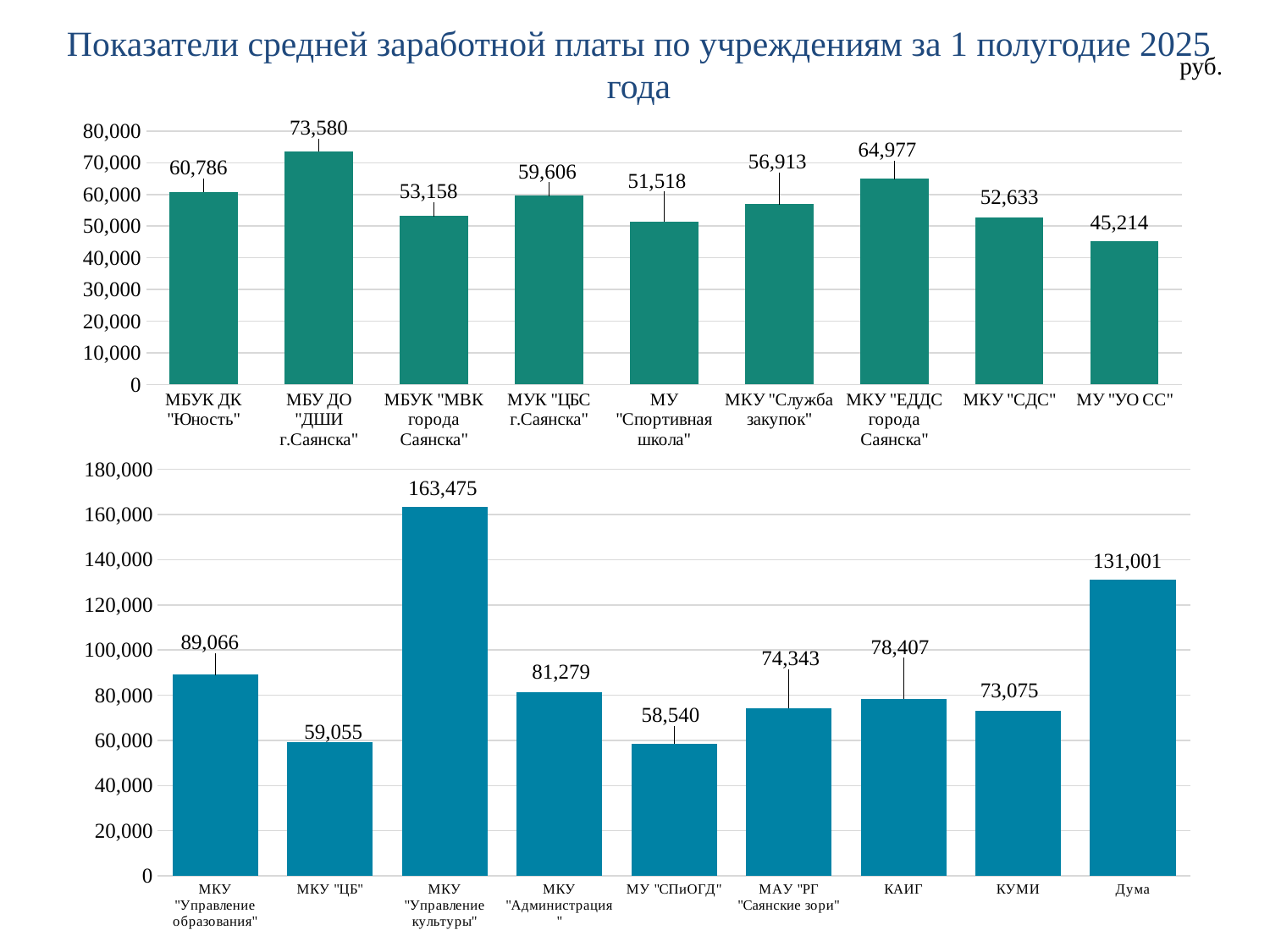
In the top chart, what is the difference between the highest and lowest values? 28,366 In the top chart, what is the value for МБУ ДО "ДШИ г.Саянска"? 73,580 In the bottom chart, what is the difference between МКУ "Управление культуры" and Дума? 32,474 In the top chart, which is larger: МКУ "Служба закупок" or МКУ "ЕДДС города Саянска"? МКУ "ЕДДС города Саянска" What is the title of the slide's charts? Показатели средней заработной платы по учреждениям за 1 полугодие 2025 года In the top chart, how many categories are shown? 9 In the bottom chart, which category has the lowest value? МУ "СПиОГД" What type of chart is the bottom chart? Bar chart In the bottom chart, what is the value for Дума? 131,001 In the bottom chart, which category has the highest value? МКУ "Управление культуры" In the bottom chart, what is the value for КАИГ? 78,407 In the top chart, which category has the lowest value? МУ "УО СС"